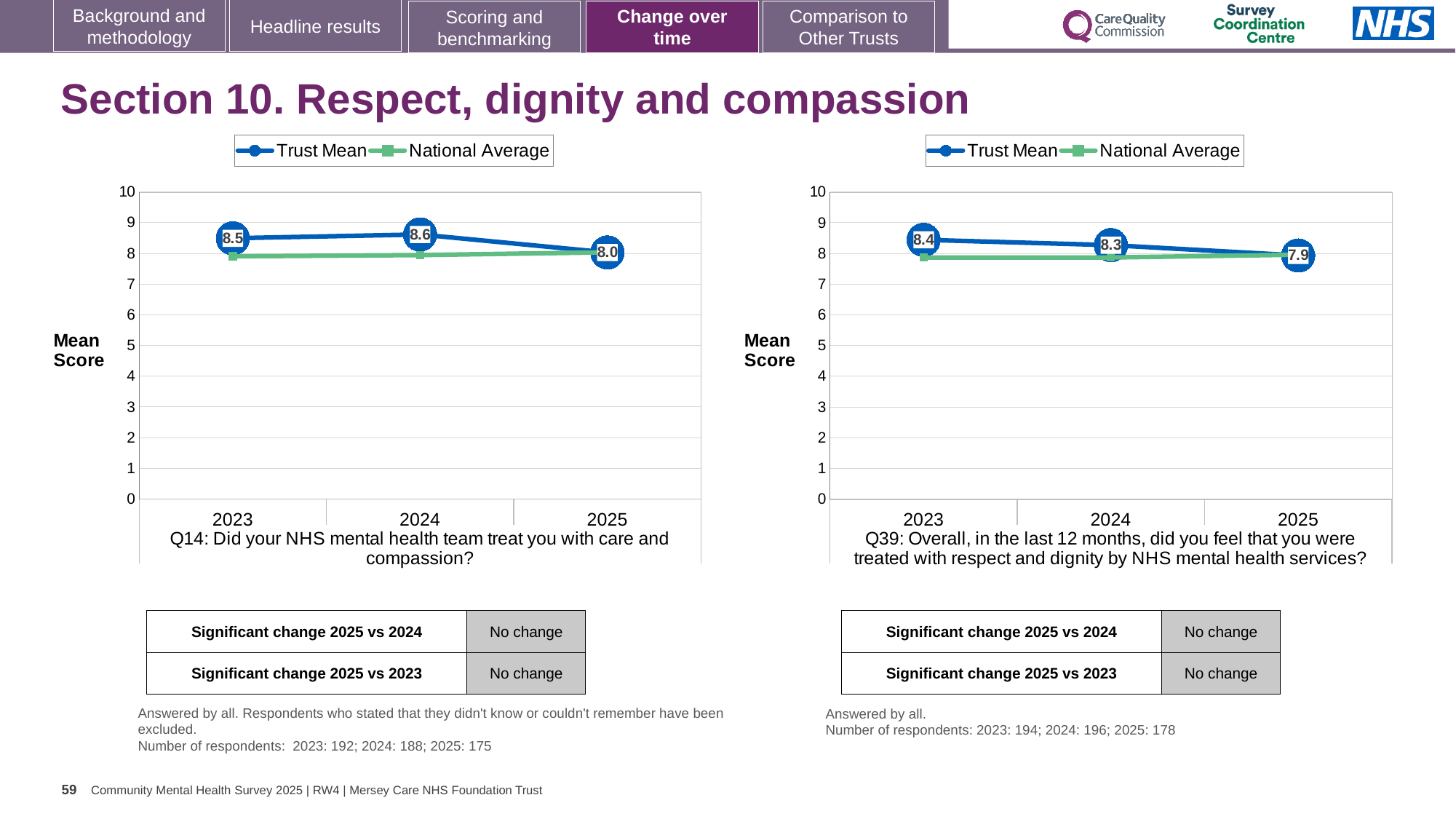
In the Q39 chart on the right, which year has the lowest Trust Mean? 2025 Is the 2023 Trust Mean higher in the Q14 chart on the left or in the Q39 chart on the right? Q14 chart on the left In the Q39 chart on the right, does the Trust Mean rise or fall from 2023 to 2025? Fall In the Q39 chart on the right, what is the Trust Mean for 2025? 7.9 What type of chart is the Q39 chart on the right? Line chart In the Q14 chart on the left, is the National Average for 2023 greater or less than 7? greater In the Q14 chart on the left, which year has the highest Trust Mean? 2024 How many years are plotted on the x axis of the Q39 chart on the right? 3 In the Q14 chart on the left, what is the difference between the Trust Mean in 2024 and in 2025? 0.6 In the Q39 chart on the right, what is the difference between the Trust Mean in 2023 and in 2025? 0.5 How many series does the legend of the Q14 chart on the left list? 2 In the Q14 chart on the left, what is the Trust Mean for 2024? 8.6